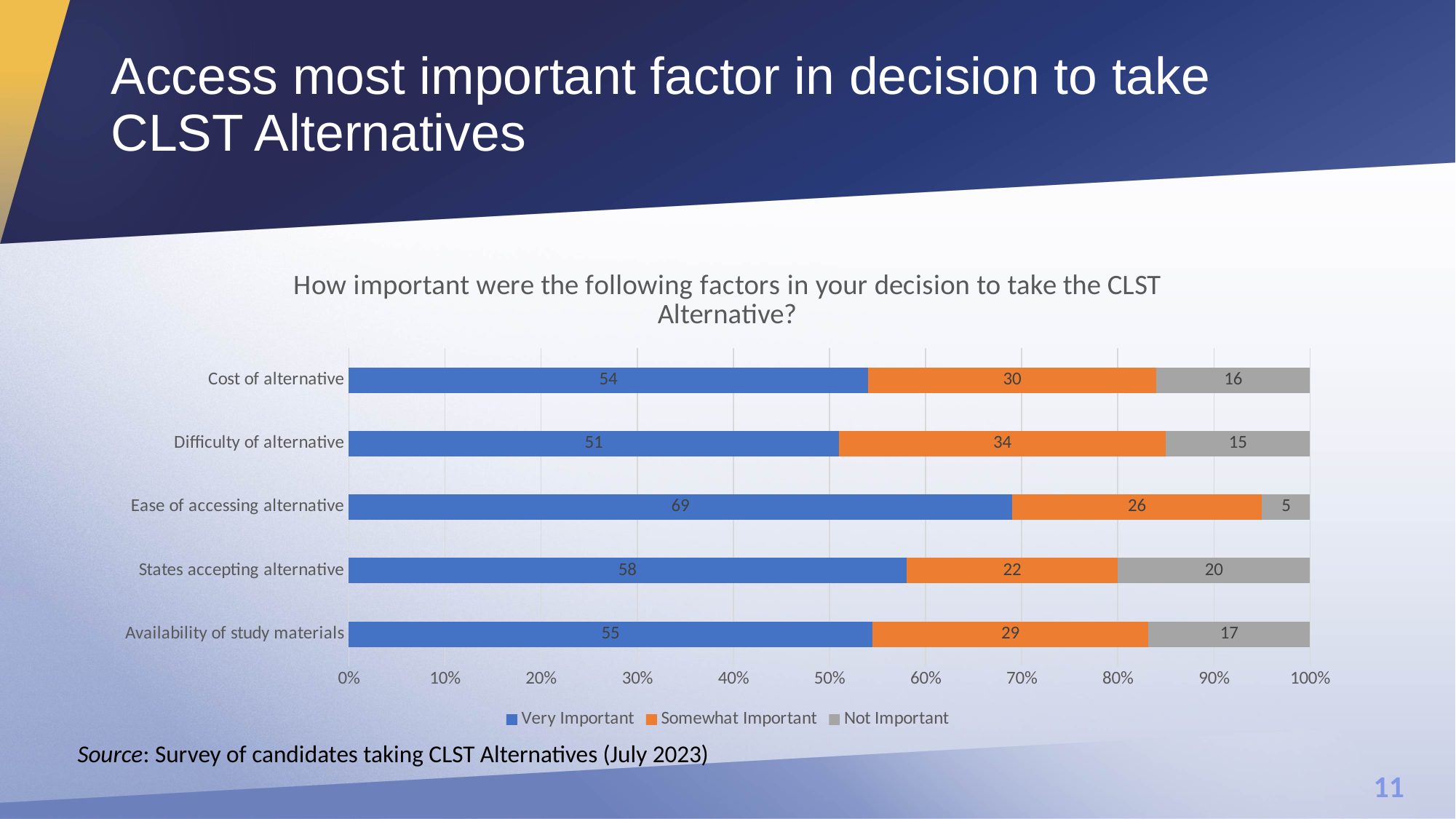
Which factor has the highest 'Very Important' value? Ease of accessing alternative What is the 'Somewhat Important' value for Difficulty of alternative? 34 How many factors (categories) are shown in the chart? 5 What is the 'Very Important' value for Ease of accessing alternative? 69 What is the total of the stacked bar for Availability of study materials? 101 What is the 'Not Important' value for States accepting alternative? 20 How many series does the legend list? 3 Which factor has the lowest 'Not Important' value? Ease of accessing alternative What is the difference between the 'Very Important' values for Ease of accessing alternative and Difficulty of alternative? 18 Which has a larger 'Somewhat Important' value, Cost of alternative or States accepting alternative? Cost of alternative What kind of chart is shown on the slide? Stacked bar chart Which colour represents the 'Not Important' series in the chart? Gray